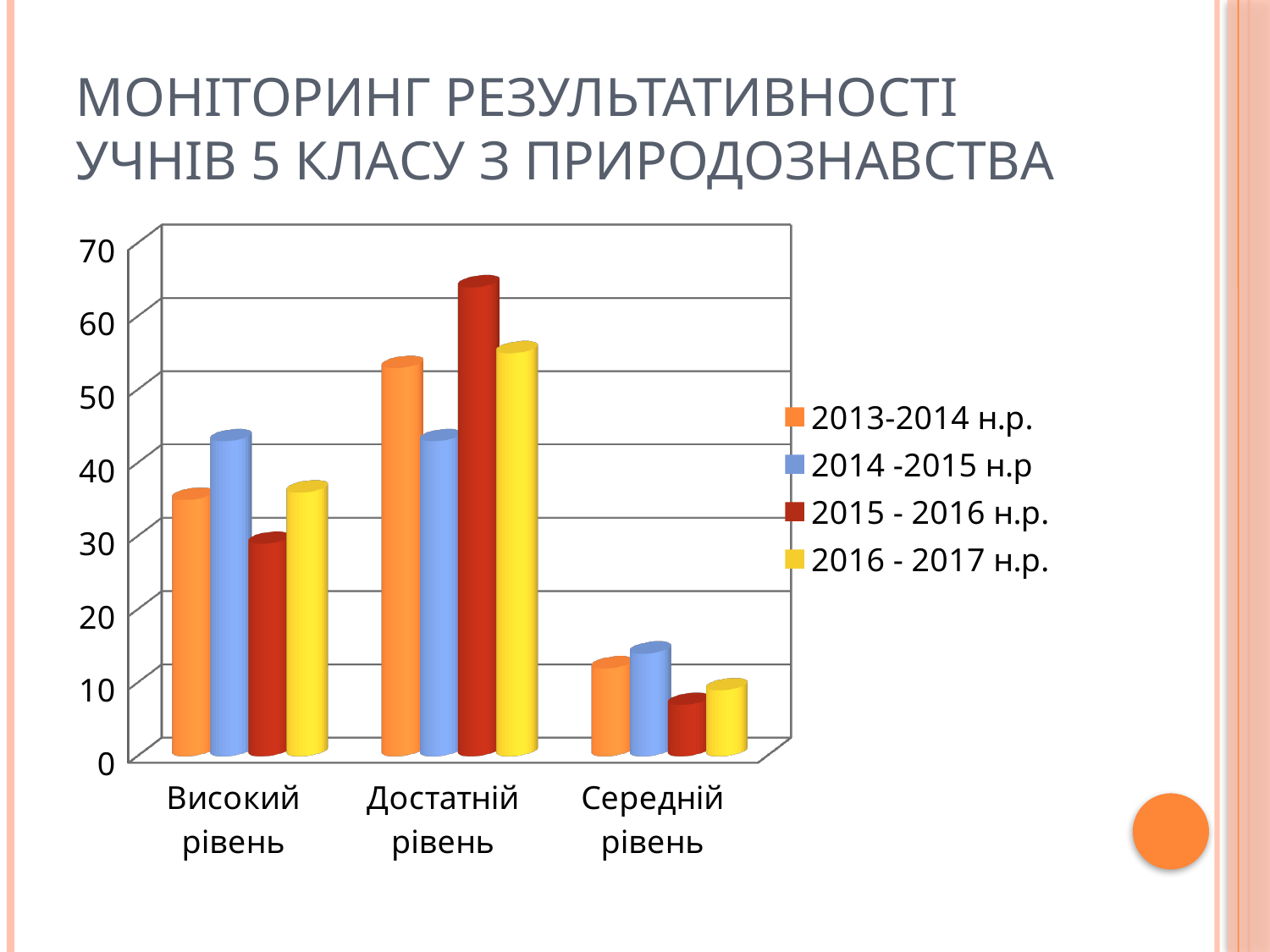
Which category has the highest values overall across all series? Достатній рівень Which series has the highest value for Високий рівень? 2014 -2015 н.р How many series does the chart's legend list? 4 Which series has the lowest value for Середній рівень? 2015 - 2016 н.р. Is the value for 2013-2014 н.р. in Достатній рівень greater or less than 50? greater For Достатній рівень, which is larger: the value for 2013-2014 н.р. or the value for 2014 -2015 н.р? 2013-2014 н.р. How many categories are shown on the x axis of the chart? 3 Is the value for 2015 - 2016 н.р. in Достатній рівень greater or less than 60? greater Which series has the highest value for Достатній рівень? 2015 - 2016 н.р. What kind of chart is shown on the slide? bar chart Is the value for 2015 - 2016 н.р. in Середній рівень greater or less than 10? less Which series has the lowest value for Високий рівень? 2015 - 2016 н.р.